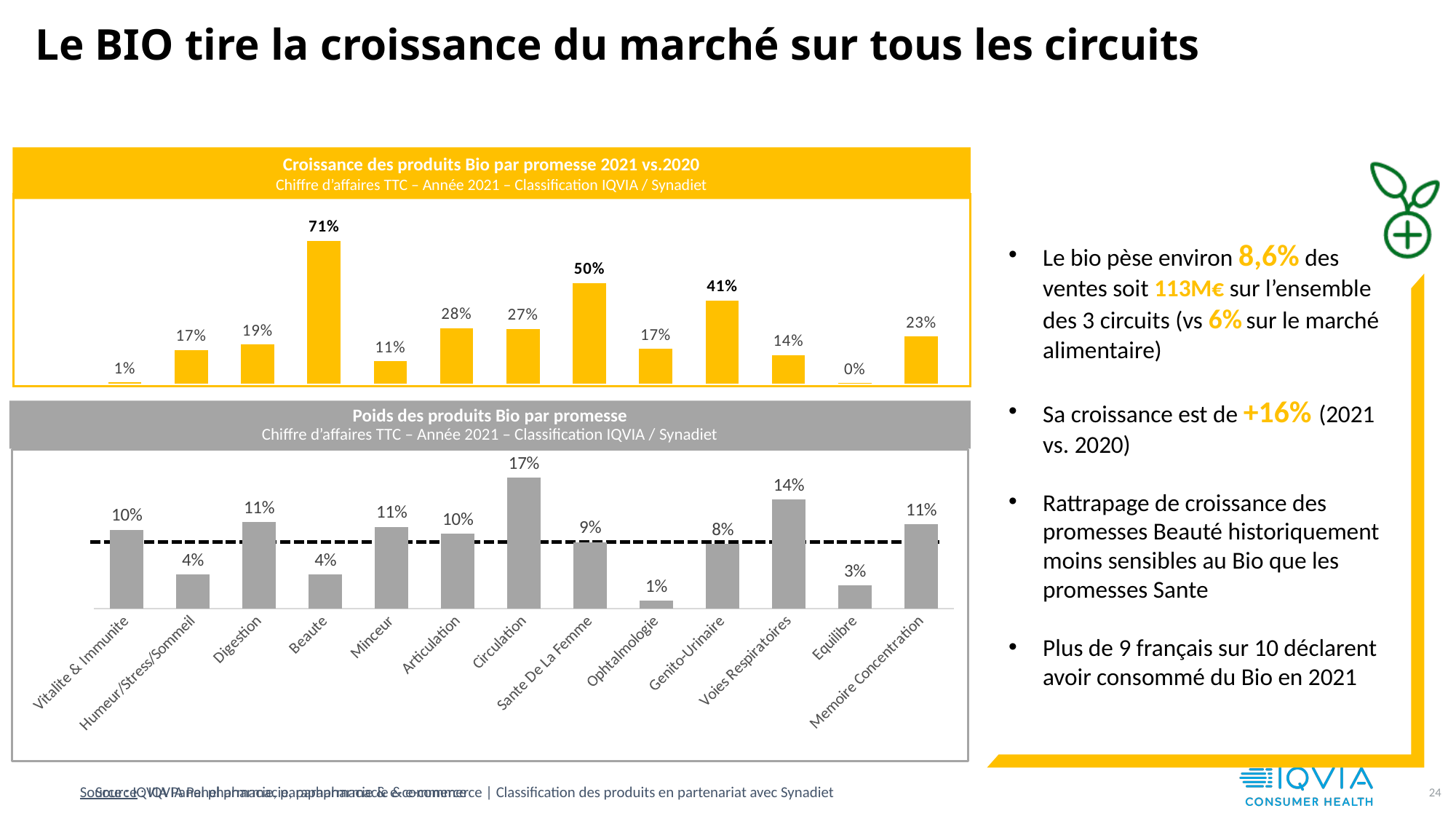
In the chart 'Croissance des produits Bio par promesse 2021 vs.2020', what is the value for Beaute? 71% In the chart 'Poids des produits Bio par promesse', which is larger, Voies Respiratoires or Genito-Urinaire? Voies Respiratoires In the chart 'Croissance des produits Bio par promesse 2021 vs.2020', which category has the lowest value? Equilibre In the chart 'Poids des produits Bio par promesse', which category has the lowest value? Ophtalmologie What type of chart is 'Croissance des produits Bio par promesse 2021 vs.2020'? Bar chart In the chart 'Croissance des produits Bio par promesse 2021 vs.2020', what is the difference between Sante De La Femme and Genito-Urinaire? 9% In the chart 'Croissance des produits Bio par promesse 2021 vs.2020', what is the value for Articulation? 28% In the chart 'Poids des produits Bio par promesse', what is the value for Circulation? 17% In the chart 'Poids des produits Bio par promesse', what is the difference between Circulation and Equilibre? 14% How many categories are shown in the chart 'Poids des produits Bio par promesse'? 13 In the chart 'Croissance des produits Bio par promesse 2021 vs.2020', which category has the highest value? Beaute In the chart 'Poids des produits Bio par promesse', which category has the highest value? Circulation